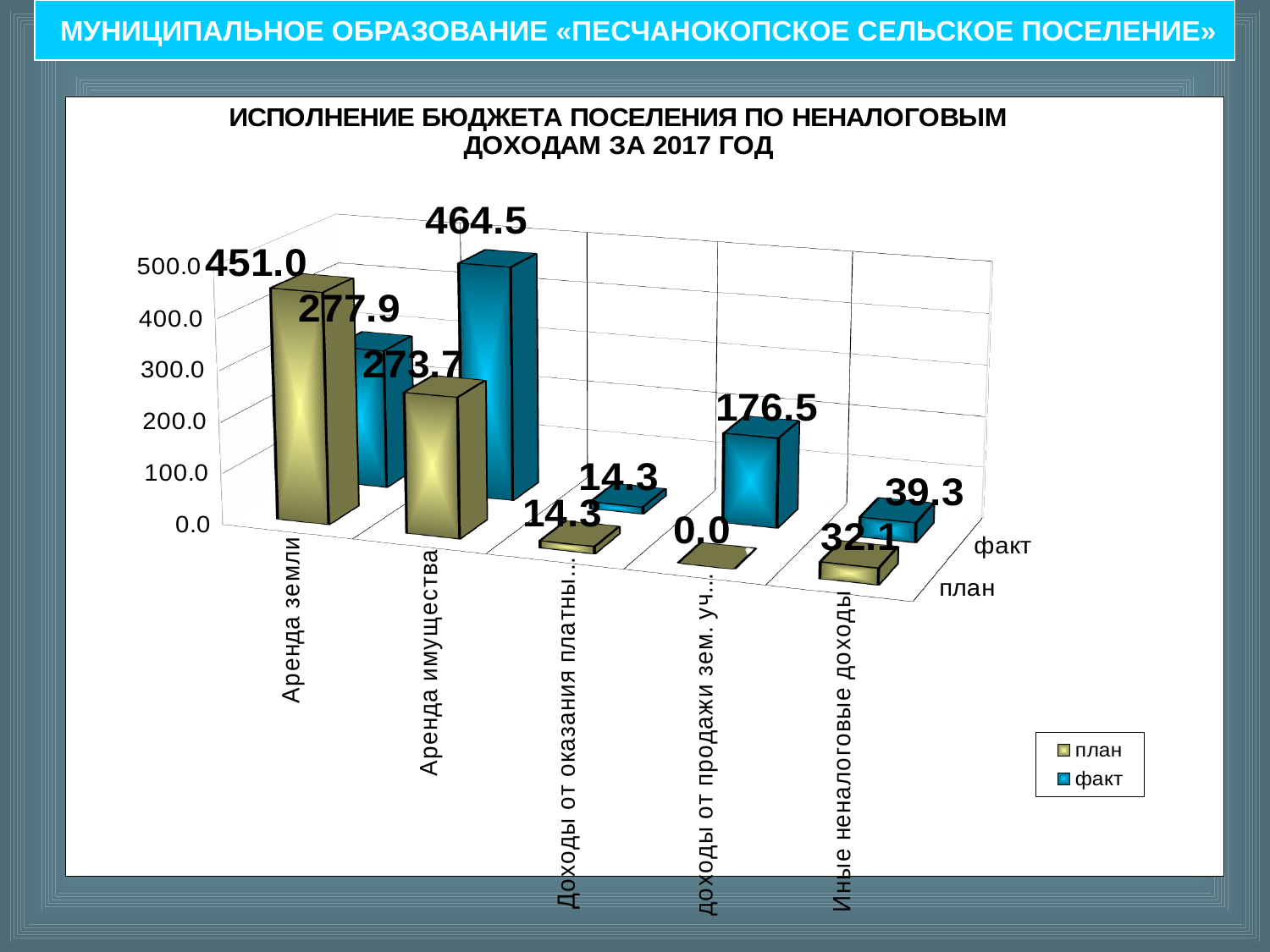
What is the difference between the факт and план values for Иные неналоговые доходы? 7.2 What is the план value for Аренда земли? 451.0 What is the факт value for Аренда земли? 277.9 How many categories are shown on the x axis? 5 What is the difference between the факт and план values for Аренда имущества? 190.8 What kind of chart is shown on the slide? bar chart Which category has the lowest план value? Доходы от продажи зем. уч... What is the план value for Иные неналоговые доходы? 32.1 How many series does the legend list? 2 What is the факт value for Аренда имущества? 464.5 Which is larger for Аренда земли, the план value or the факт value? план Which category has the highest факт value? Аренда имущества